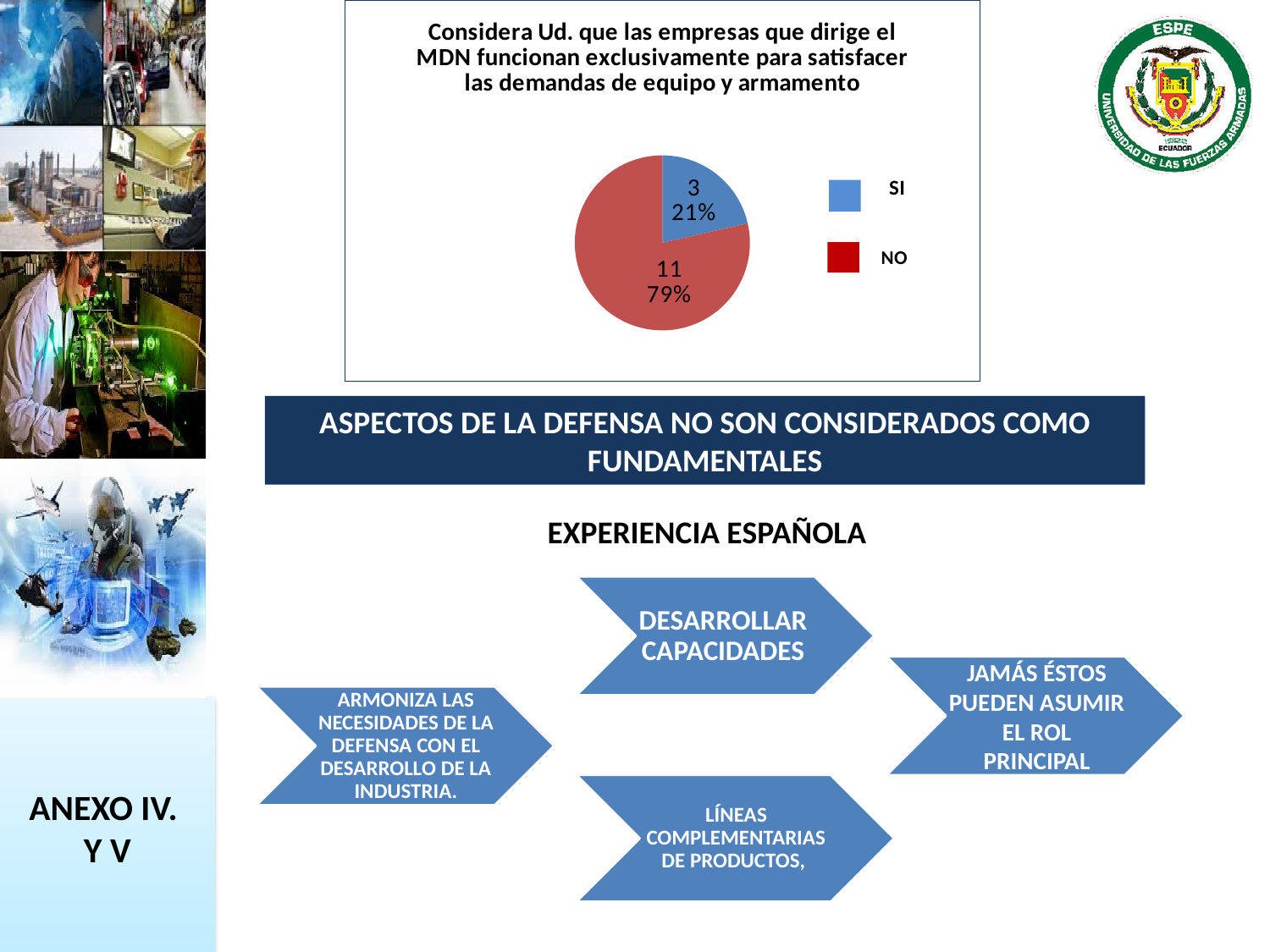
Which response has the smallest slice of the pie? SI What percentage of the pie does the NO slice represent? 79% What colour is the NO slice in the pie chart? red Which is larger, the SI count or the NO count? NO What is the difference between the number of NO and SI responses? 8 What percentage of the pie does the SI slice represent? 21% What kind of chart is shown on the slide? pie chart How many respondents answered SI? 3 How many respondents answered NO? 11 How many entries does the legend list? 2 How many slices does the pie chart have? 2 Which response has the largest slice of the pie? NO